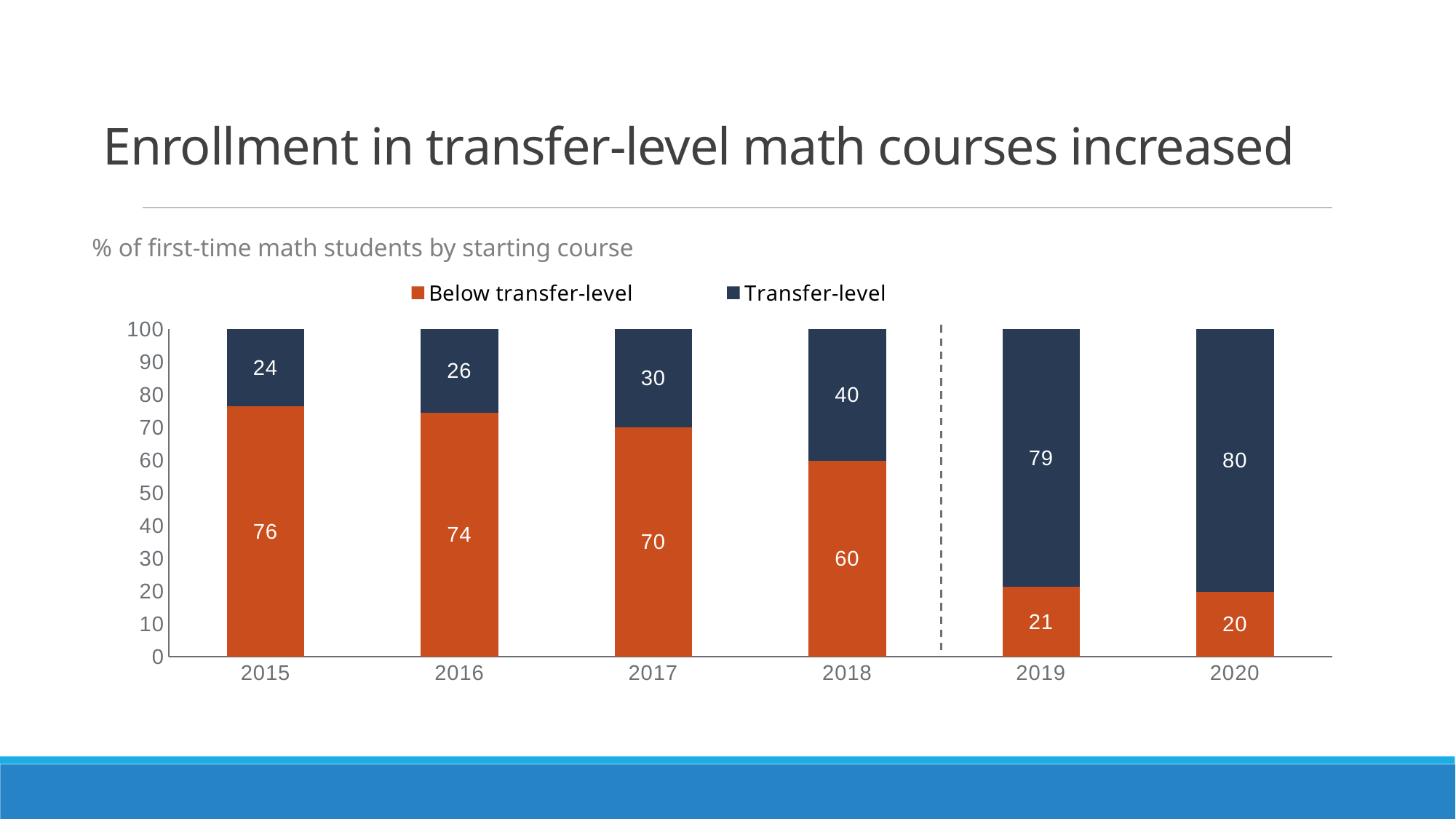
What is the total of the stacked bar for 2017? 100 Which is larger: the Transfer-level value for 2017 or the Transfer-level value for 2019? 2019 Which year has the lowest Below transfer-level value? 2020 How many years are shown on the x axis? 6 How many series does the legend list? 2 Which year has the highest Transfer-level value? 2020 What kind of chart is shown on the slide? stacked bar chart Is the Below transfer-level value for 2019 greater or less than 50? less What is the difference between the Below transfer-level values for 2015 and 2018? 16 What is the Transfer-level value for 2018? 40 Do the Transfer-level values rise or fall from 2015 to 2020? rise What is the Below transfer-level value for 2016? 74